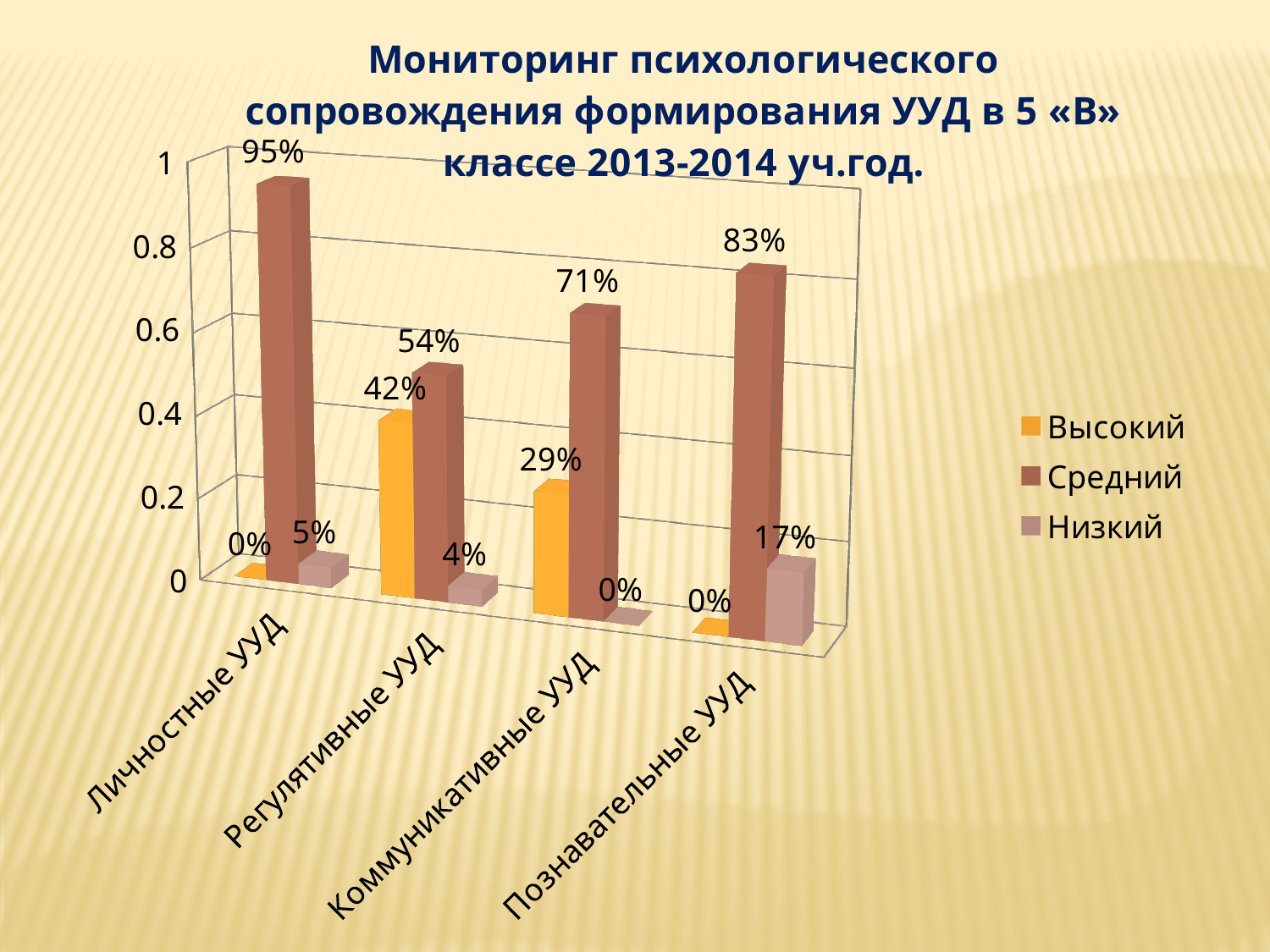
What is the value of the Высокий series for Регулятивные УУД? 42% Which category has the lowest value in the Средний series? Регулятивные УУД What is the value of the Высокий series for Коммуникативные УУД? 29% Which is larger for Познавательные УУД: the Средний value or the Низкий value? Средний What is the value of the Средний series for Личностные УУД? 95% How many series does the legend list? 3 What is the value of the Низкий series for Познавательные УУД? 17% Which category has the highest value in the Средний series? Личностные УУД How many categories are shown on the x axis? 4 Which series is shown in orange in the legend? Высокий What is the difference between the Средний and Высокий values for Регулятивные УУД? 12% What kind of chart is shown on the slide? Bar chart